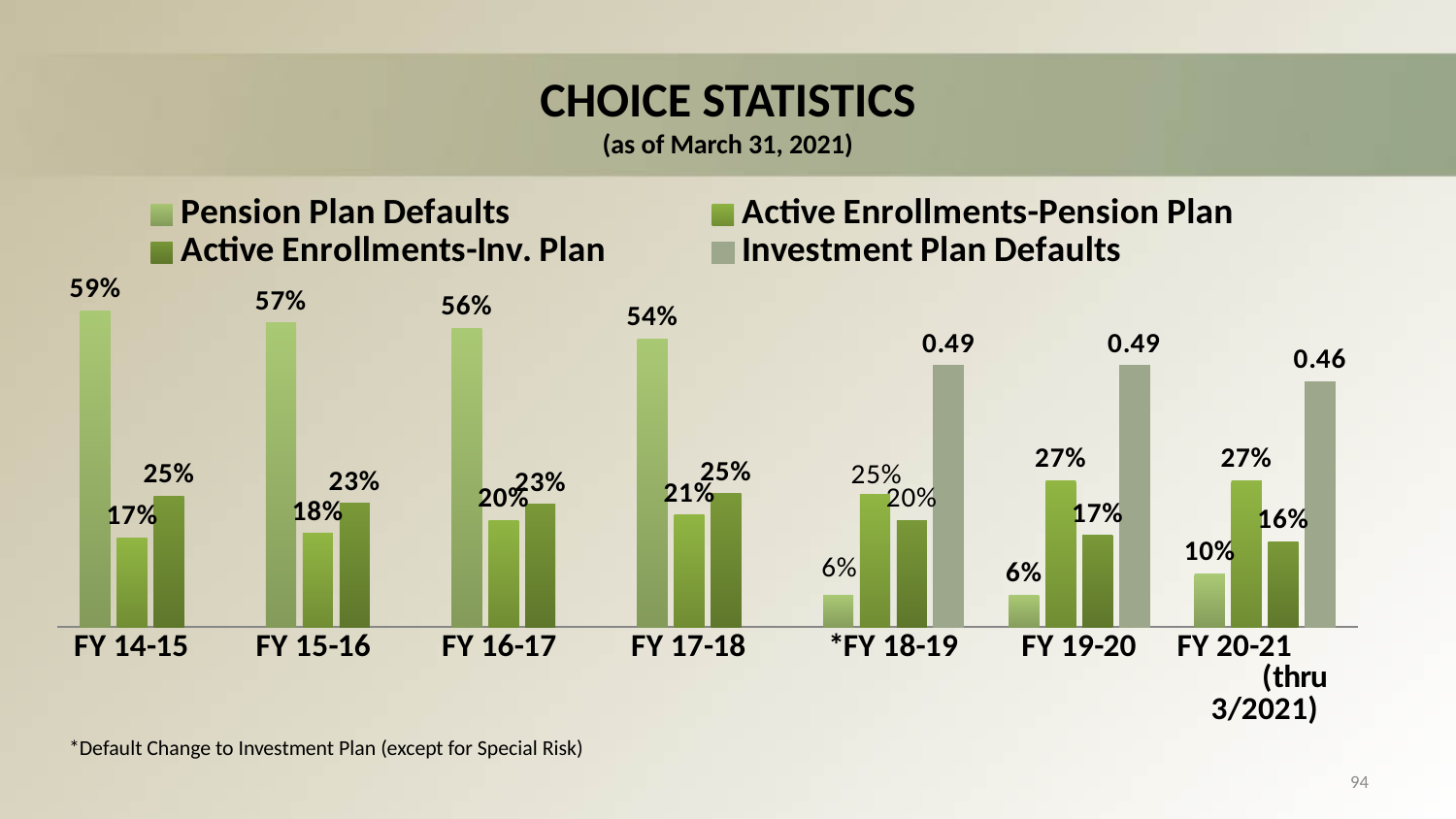
How many fiscal year categories are shown on the x axis? 7 In FY 17-18, which is larger: Active Enrollments-Pension Plan or Active Enrollments-Inv. Plan? Active Enrollments-Inv. Plan What kind of chart is shown on the slide? Bar chart What date is the chart's data reported as of, according to the subtitle? March 31, 2021 What is the Investment Plan Defaults value for FY 20-21 (thru 3/2021)? 0.46 Do the Pension Plan Defaults values rise or fall from FY 14-15 to FY 17-18? Fall Which fiscal year has the lowest Active Enrollments-Pension Plan value? FY 14-15 What is the Active Enrollments-Inv. Plan value for FY 19-20? 17% How many series does the legend list? 4 What is the Pension Plan Defaults value for FY 14-15? 59% Which fiscal year has the highest Pension Plan Defaults value? FY 14-15 In FY 14-15, how much higher is Active Enrollments-Inv. Plan than Active Enrollments-Pension Plan? 8 percentage points